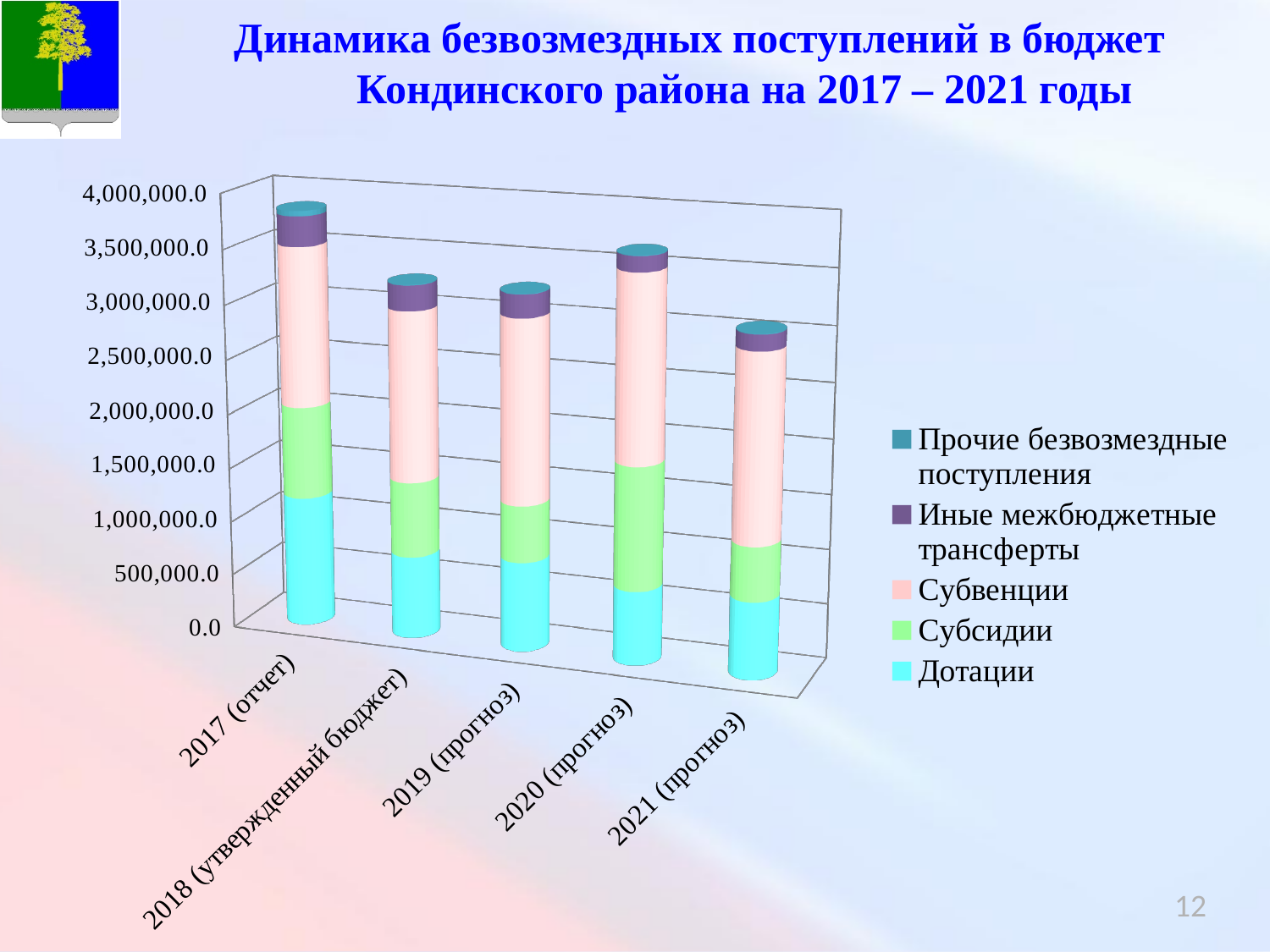
Which year has the shortest stacked bar in the chart? 2021 (прогноз) How many series does the chart legend list? 5 Which series is shown at the bottom of each stacked bar? Дотации What is the title of the chart on the slide? Динамика безвозмездных поступлений в бюджет Кондинского района на 2017 – 2021 годы Which year has the tallest stacked bar in the chart? 2017 (отчет) Is the total stacked bar for 2017 (отчет) greater or less than 3,500,000.0? greater How many categories (years) are shown on the x axis of the chart? 5 What kind of chart is shown on the slide? Stacked bar chart Which stacked bar is taller: 2020 (прогноз) or 2018 (утвержденный бюджет)? 2020 (прогноз) Is the Дотации segment for 2017 (отчет) greater or less than 1,000,000.0? greater